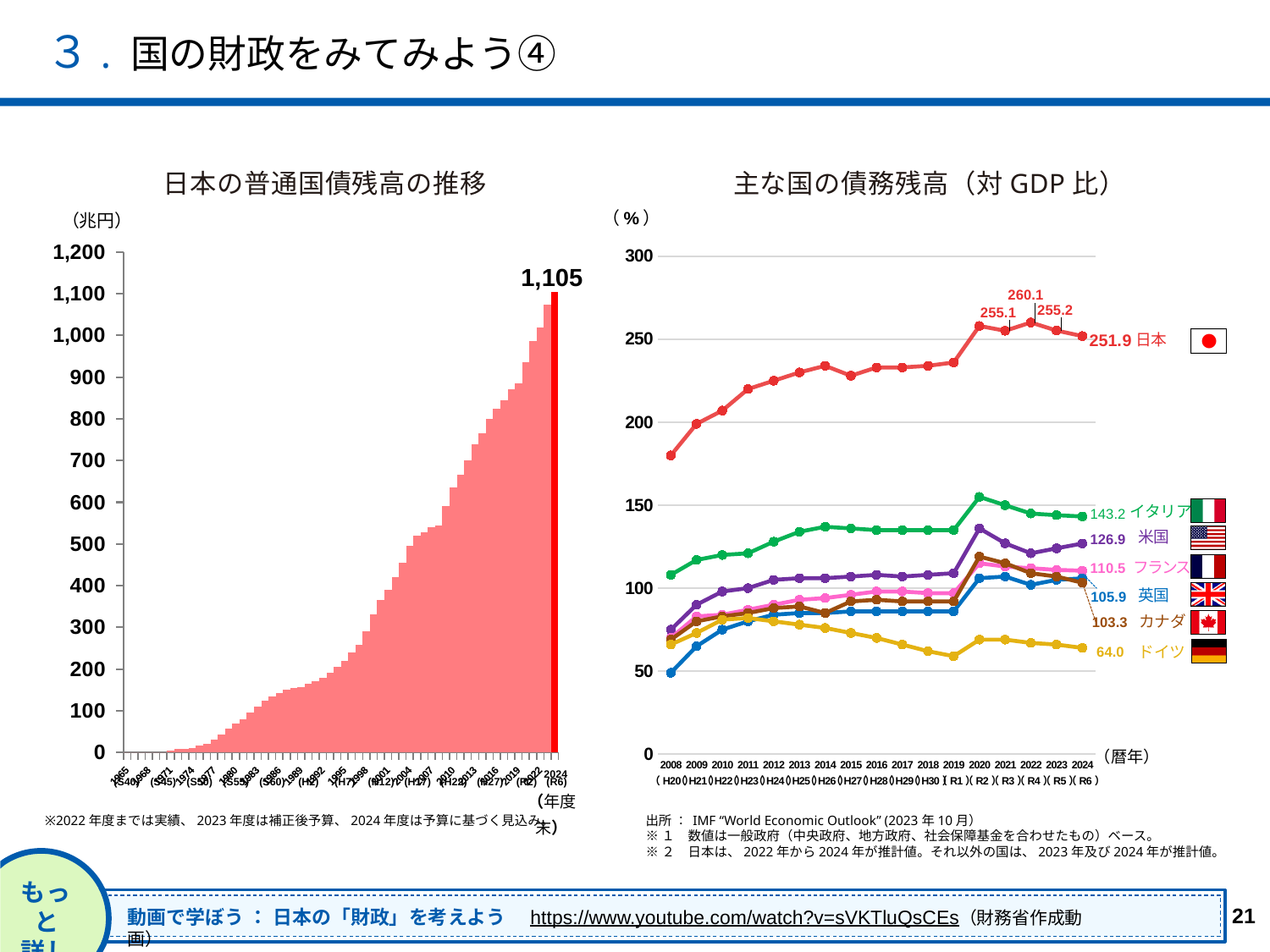
In the left chart, 日本の普通国債残高の推移, what is the value shown for 2024? 1,105 In the right chart, 主な国の債務残高（対GDP比）, what is the value for 日本 in 2024? 251.9 What kind of chart is the left chart, 日本の普通国債残高の推移? bar chart In the right chart, 主な国の債務残高（対GDP比）, what is the difference between the 2024 values for 日本 and ドイツ? 187.9 In the right chart, 主な国の債務残高（対GDP比）, what is the value for 日本 in 2021? 255.1 In the right chart, 主な国の債務残高（対GDP比）, how many countries are plotted? 7 What unit is shown on the y axis of the left chart, 日本の普通国債残高の推移? 兆円 In the right chart, 主な国の債務残高（対GDP比）, what is the value for ドイツ in 2024? 64.0 In the right chart, 主な国の債務残高（対GDP比）, which country has the highest value in 2024? 日本 In the left chart, 日本の普通国債残高の推移, do the values generally rise or fall from left to right along the x axis? rise What kind of chart is the right chart, 主な国の債務残高（対GDP比）? line chart In the right chart, 主な国の債務残高（対GDP比）, which country has the lowest value in 2024? ドイツ